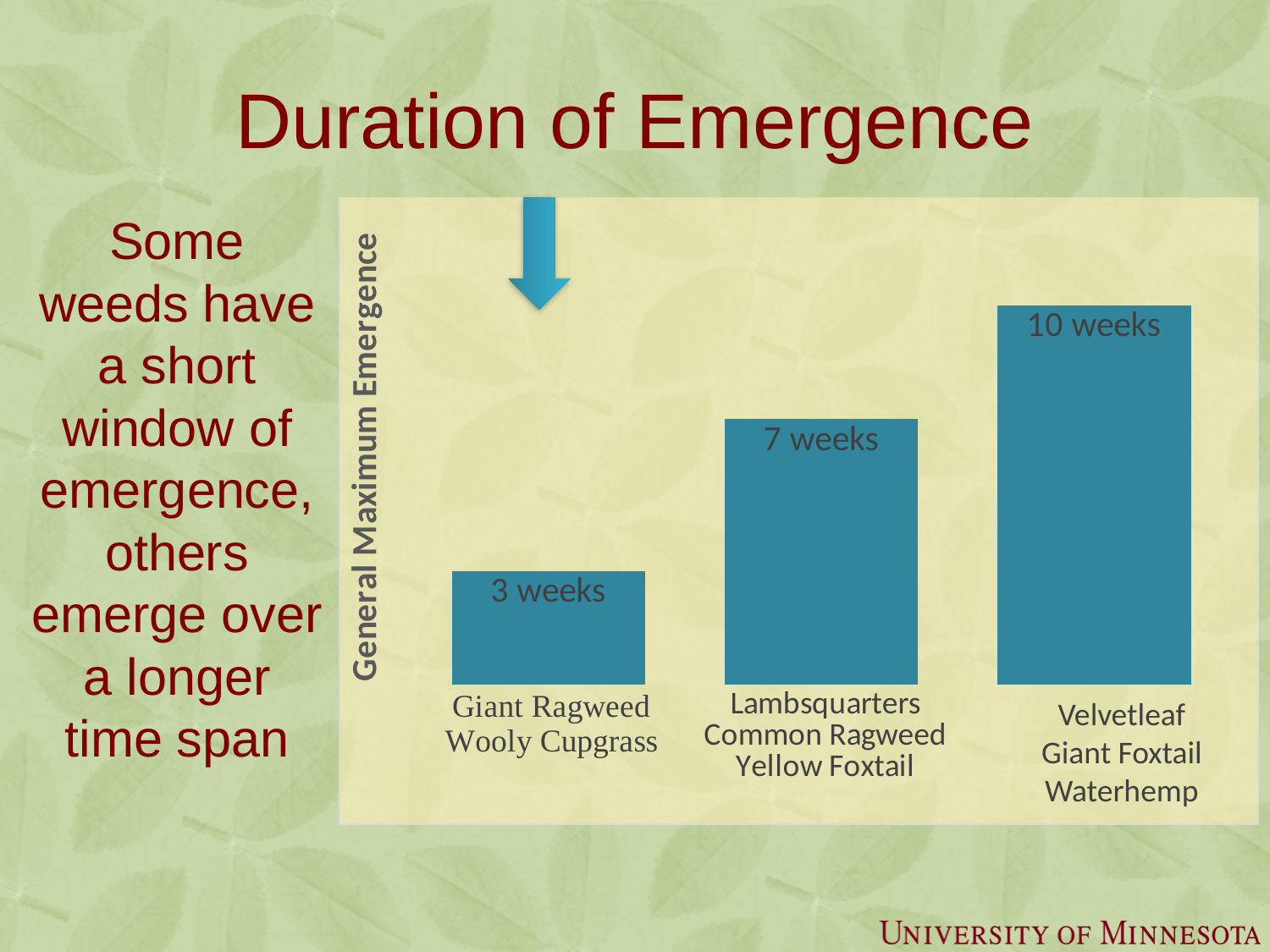
How many bars are shown in the chart? 3 How many weeks longer is the emergence duration for the Velvetleaf group than for the Giant Ragweed group? 7 weeks What is the general maximum emergence duration for Lambsquarters, Common Ragweed and Yellow Foxtail? 7 weeks What is the general maximum emergence duration for Giant Ragweed and Wooly Cupgrass? 3 weeks How many weeks longer is the emergence duration for the Lambsquarters group than for the Giant Ragweed group? 4 weeks Do the bar values rise or fall from left to right across the chart? Rise Which has a longer emergence duration: the Lambsquarters group or the Velvetleaf group? Velvetleaf group What is the general maximum emergence duration for Velvetleaf, Giant Foxtail and Waterhemp? 10 weeks What type of chart is shown on the slide? Bar chart What is the label on the vertical axis of the chart? General Maximum Emergence Which group of weeds has the shortest general maximum emergence? Giant Ragweed, Wooly Cupgrass Which group of weeds has the longest general maximum emergence? Velvetleaf, Giant Foxtail, Waterhemp